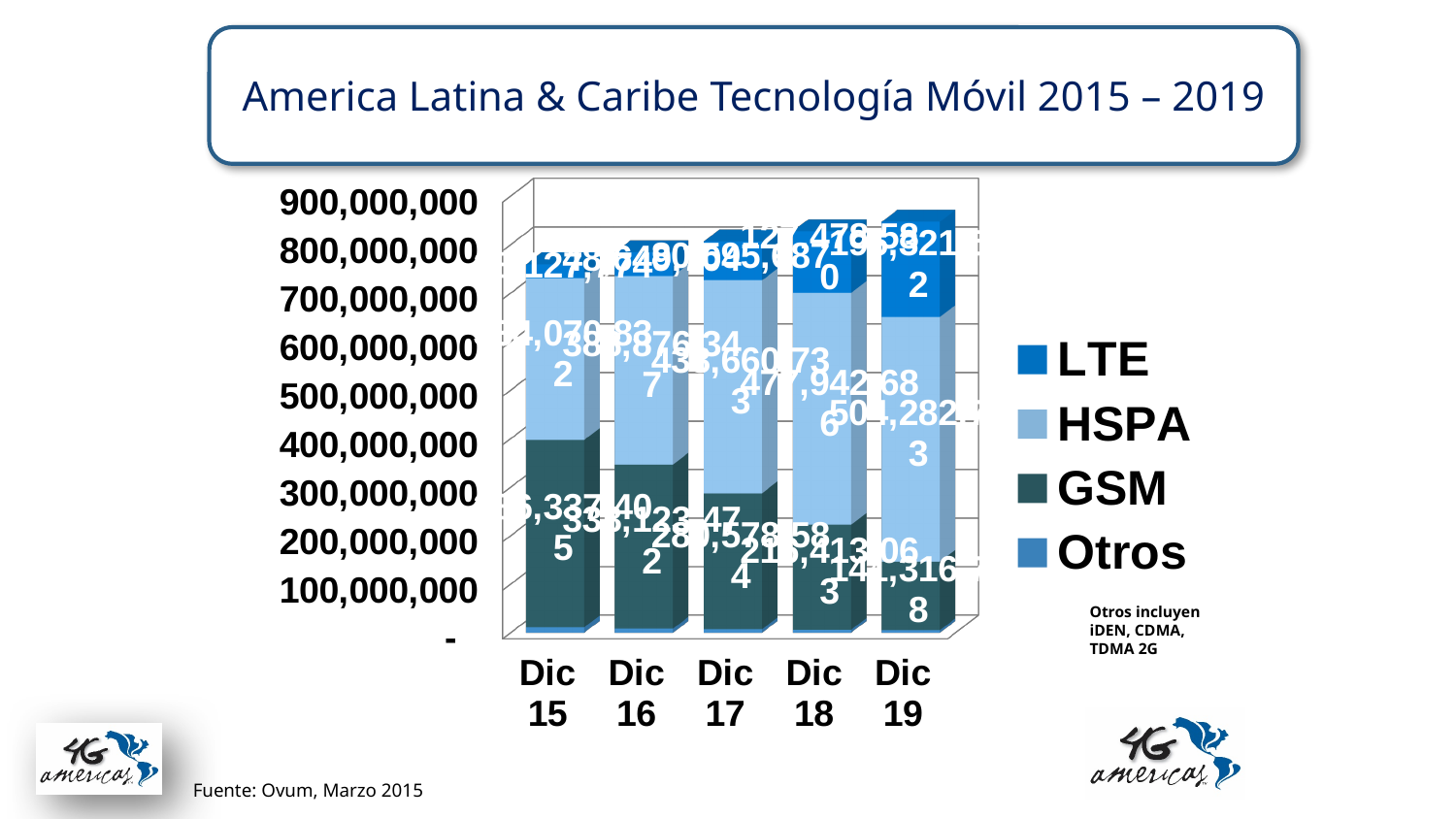
Is the LTE segment larger in Dic 15 or Dic 19? Dic 19 Is the total for Dic 19 greater or less than 800,000,000? greater How many series does the legend list? 4 Which period has the smallest LTE segment? Dic 15 According to the note on the slide, what technologies does 'Otros' include? iDEN, CDMA, TDMA 2G Does the GSM segment rise or fall from Dic 15 to Dic 19? Fall Which period has the tallest total bar? Dic 19 What is the title of the chart? America Latina & Caribe Tecnología Móvil 2015 – 2019 Which period has the largest GSM segment? Dic 15 How many time periods (categories) are shown on the x axis? 5 Does the LTE segment rise or fall from Dic 15 to Dic 19? Rise What kind of chart is shown on the slide? Stacked bar chart